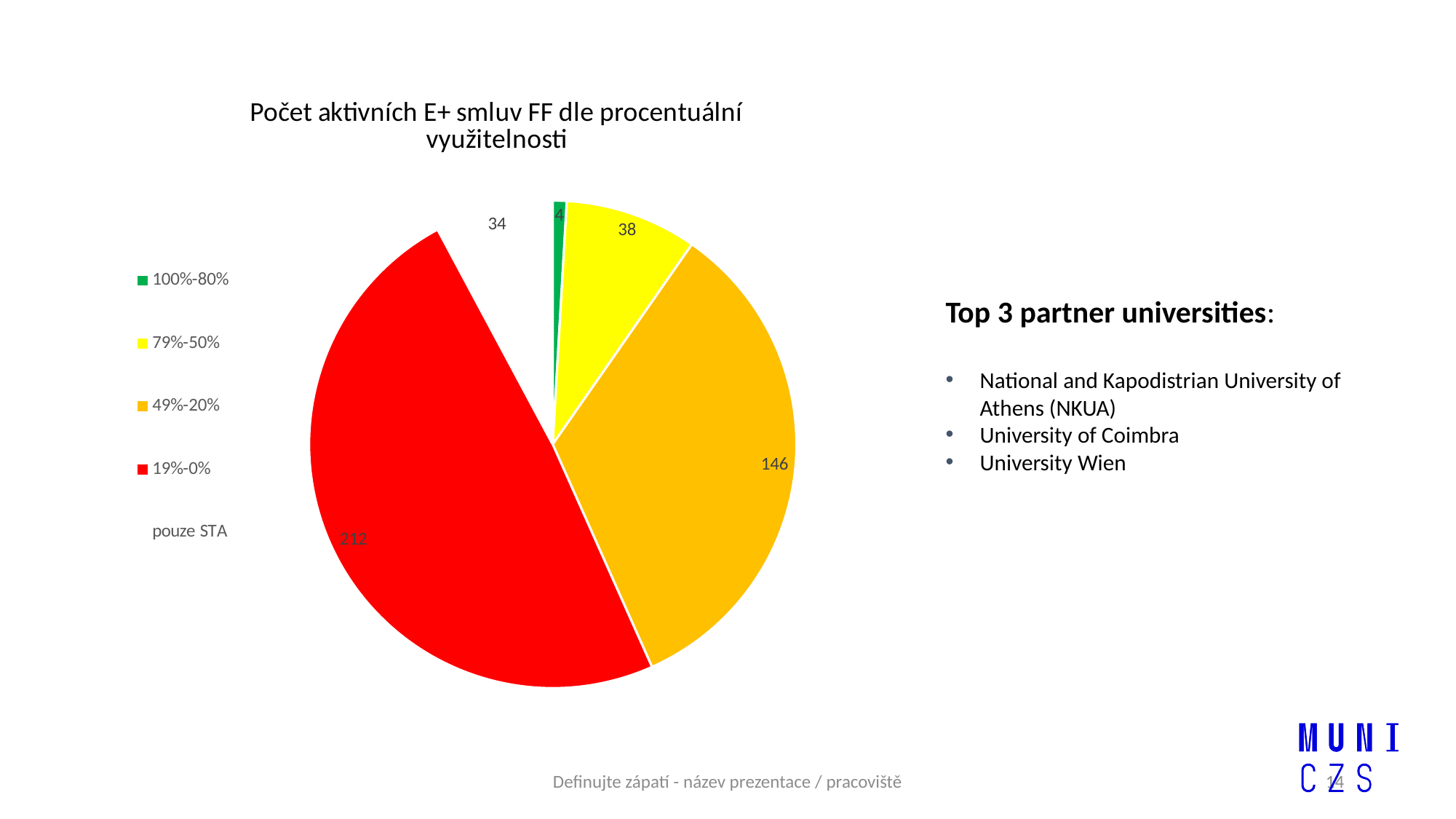
Which category has the smallest slice? 100%-80% How many slices does the pie chart have? 5 What is the value of the 79%-50% slice? 38 What is the value of the 19%-0% slice? 212 Which is larger, the 79%-50% slice or the pouze STA slice? 79%-50% What is the value of the 49%-20% slice? 146 Which category has the largest slice? 19%-0% What is the value of the pouze STA slice? 34 What is the difference between the 19%-0% slice and the 49%-20% slice? 66 What is the value of the 100%-80% slice? 4 What type of chart is shown on the slide? pie chart What is the title of the chart? Počet aktivních E+ smluv FF dle procentuální využitelnosti